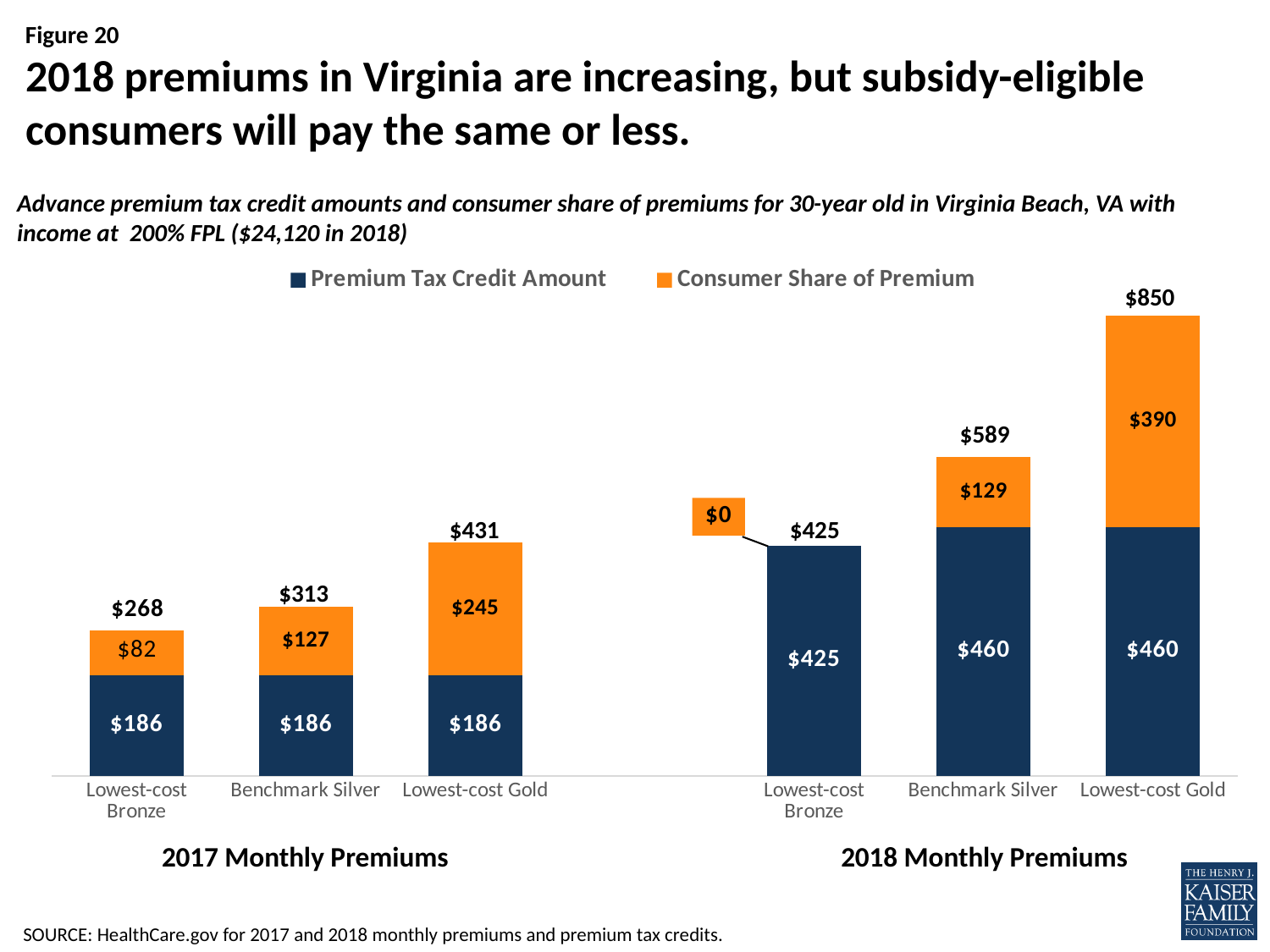
What is the Consumer Share of Premium for Lowest-cost Bronze in the 2018 Monthly Premiums group? $0 What kind of chart is shown on the slide? Stacked bar chart Which plan has the highest total monthly premium on the chart? Lowest-cost Gold (2018) What is the Consumer Share of Premium for Lowest-cost Gold in the 2017 Monthly Premiums group? $245 What is the difference between the Consumer Share of Premium for Benchmark Silver in 2018 and in 2017? $2 What is the Premium Tax Credit Amount for Benchmark Silver in the 2018 Monthly Premiums group? $460 What is the total monthly premium for Lowest-cost Gold in 2018? $850 What is the total monthly premium for Benchmark Silver in 2017? $313 Which is larger: the Premium Tax Credit Amount for Lowest-cost Bronze in 2017 or in 2018? 2018 Which plan has the lowest total monthly premium on the chart? Lowest-cost Bronze (2017) How many series does the legend list? 2 How many bars are plotted on the chart in total? 6